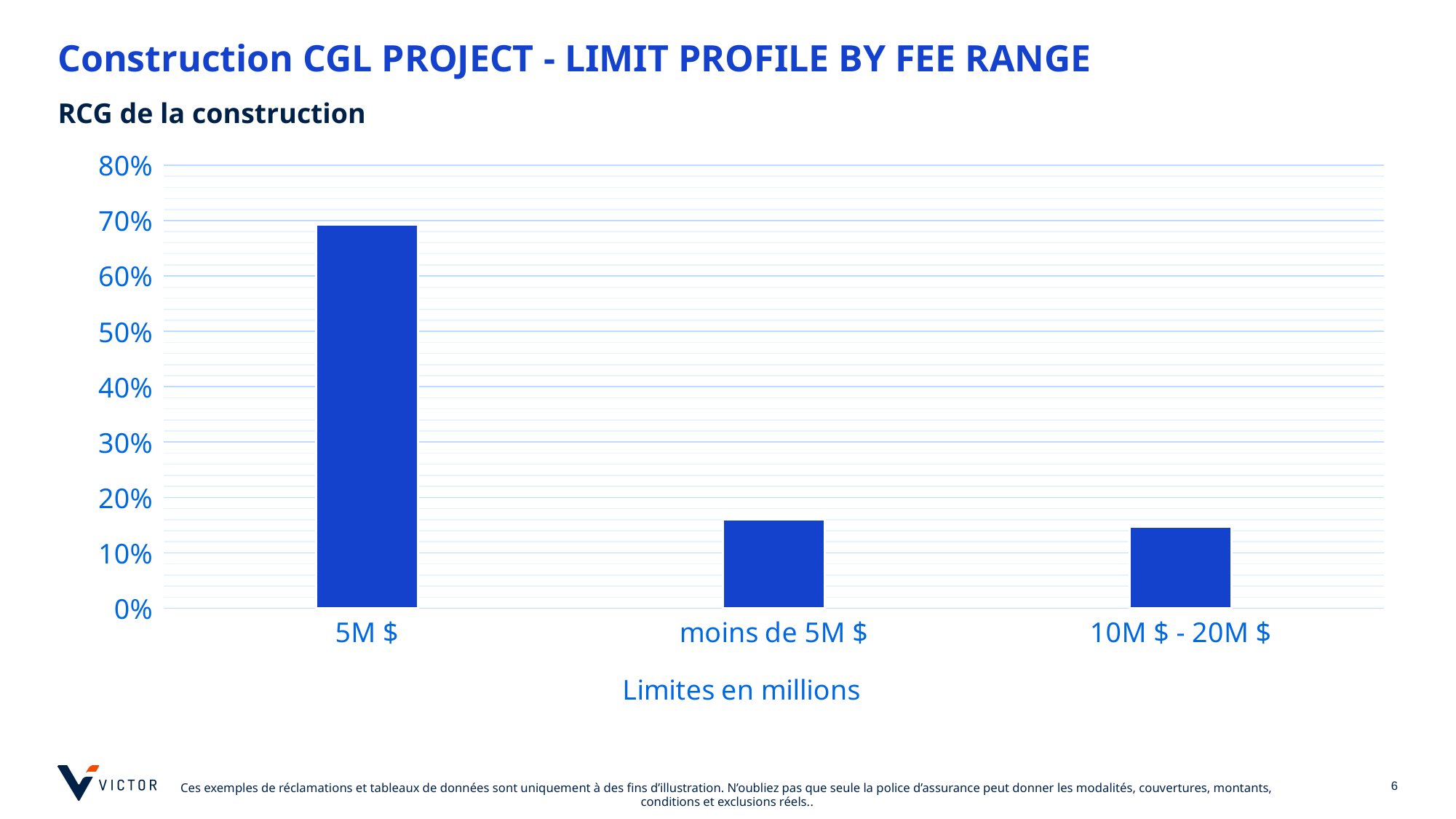
What kind of chart is shown on the slide? bar chart Is the value for 5M $ greater or less than 60%? greater Which category has the highest value in the chart? 5M $ Which is larger, the value for 5M $ or the value for 10M $ - 20M $? 5M $ What is the x-axis title of the chart? Limites en millions Is the value for moins de 5M $ greater or less than 20%? less Is the value for 10M $ - 20M $ greater or less than 20%? less Do the values rise or fall from left to right along the x axis? fall How many categories are shown on the x axis of the chart? 3